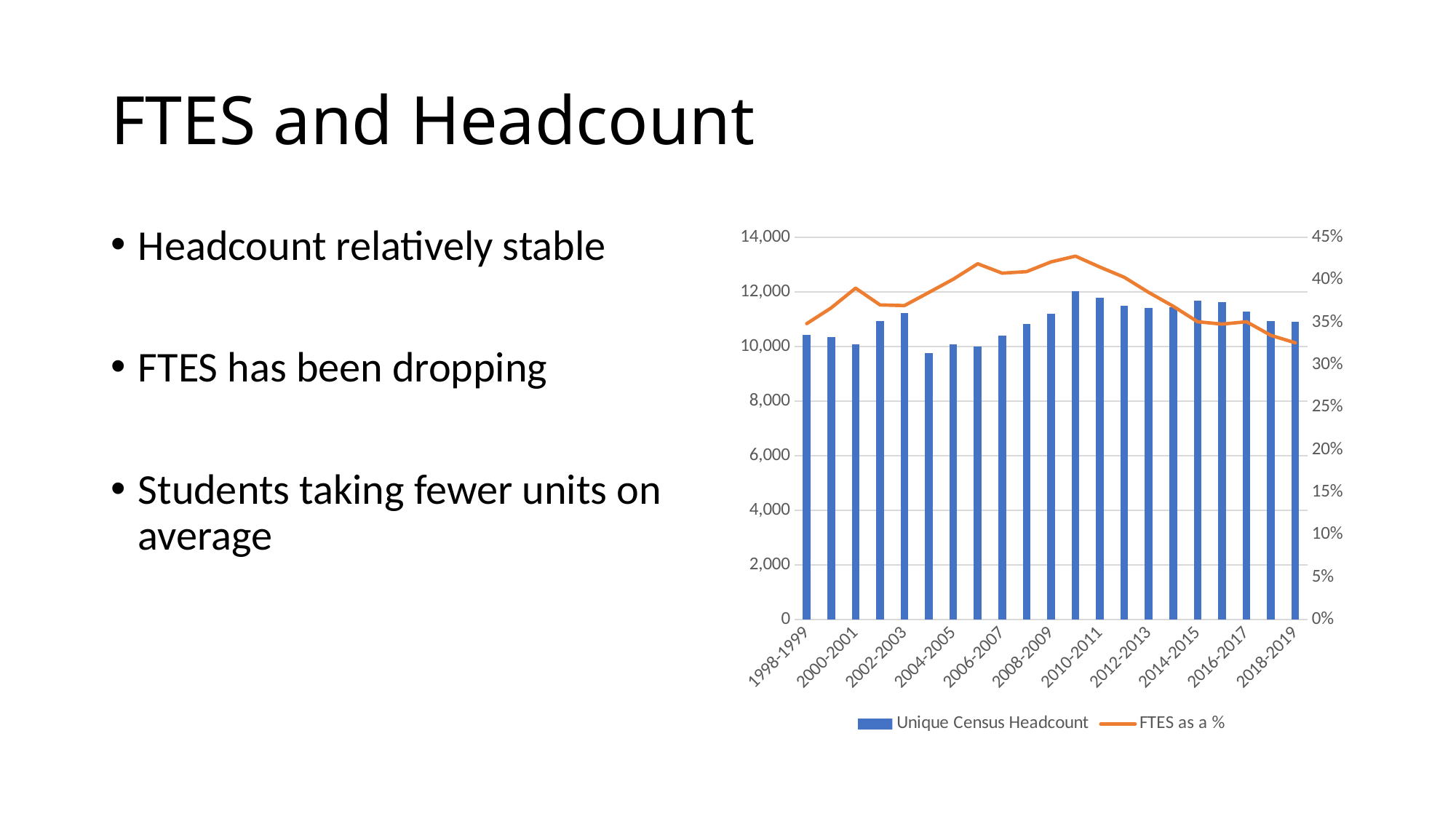
What are the two series named in the chart legend? Unique Census Headcount and FTES as a % Is the Unique Census Headcount for 2010-2011 greater or less than 11,000? greater How many series does the chart legend list? 2 Is the FTES as a % value for 2018-2019 greater or less than 35%? less Which academic year has the highest Unique Census Headcount bar? 2009-2010 Is the FTES as a % value for 2010-2011 greater or less than 40%? greater Does the FTES as a % line rise or fall from 2010-2011 to 2018-2019? fall Which is larger, the Unique Census Headcount for 2010-2011 or for 1998-1999? 2010-2011 Which academic year has the lowest Unique Census Headcount bar? 2003-2004 Which series is drawn as a line rather than bars? FTES as a % How many bars (academic years) are plotted in the chart? 21